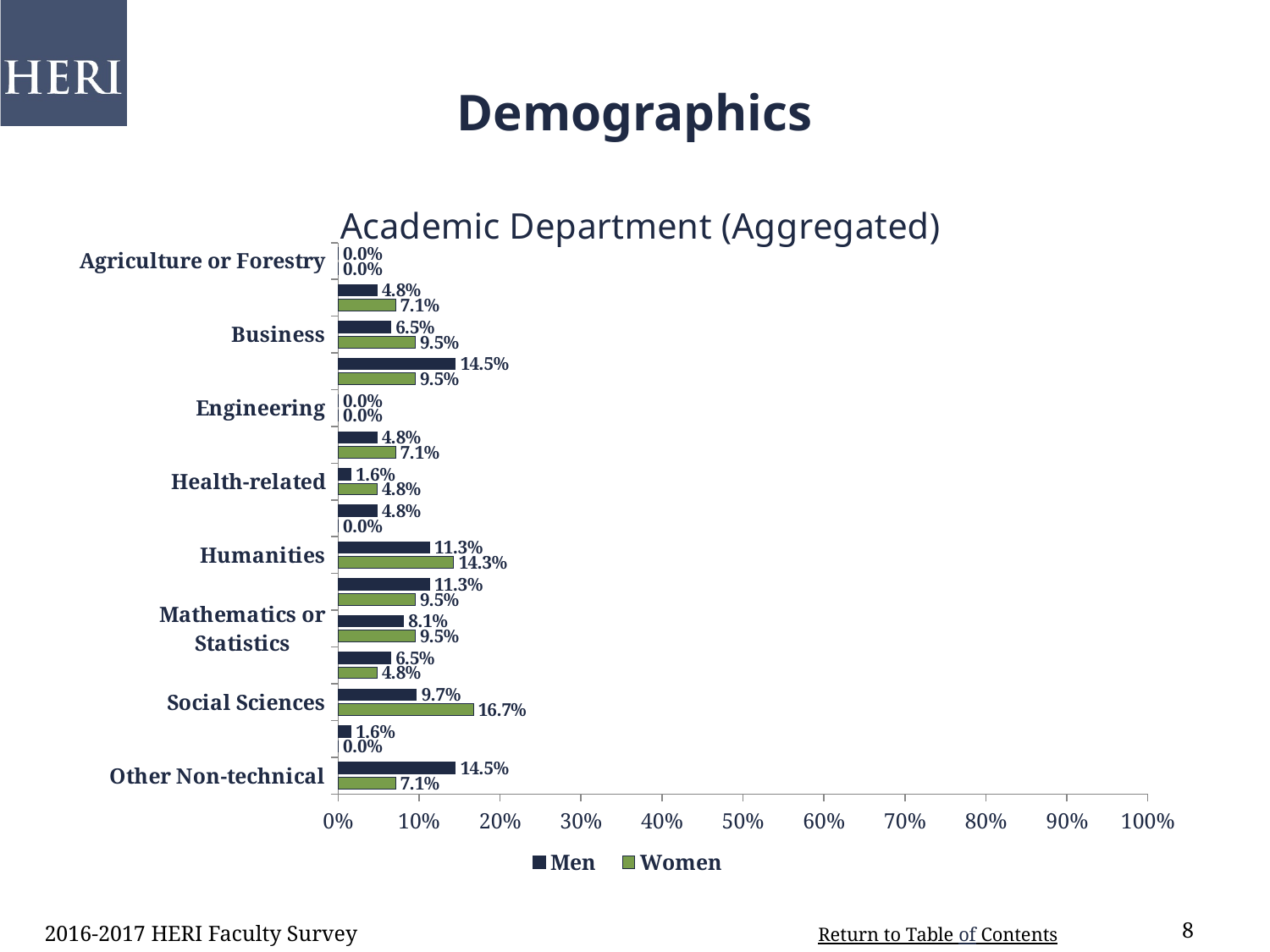
What is the difference between the Women and Men values for Social Sciences? 7.0 percentage points How many series does the legend list? 2 What is the value for Men in Health-related? 1.6% What is the value for Men in Humanities? 11.3% In Humanities, which series has the larger value, Men or Women? Women What is the value for Women in Social Sciences? 16.7% What is the value for Women in Business? 9.5% Which department has the highest value for Women? Social Sciences Is the value for Women in Social Sciences greater or less than 10%? greater In Other Non-technical, which series has the larger value, Men or Women? Men What is the value for Men in Other Non-technical? 14.5% What kind of chart is shown on the slide? bar chart